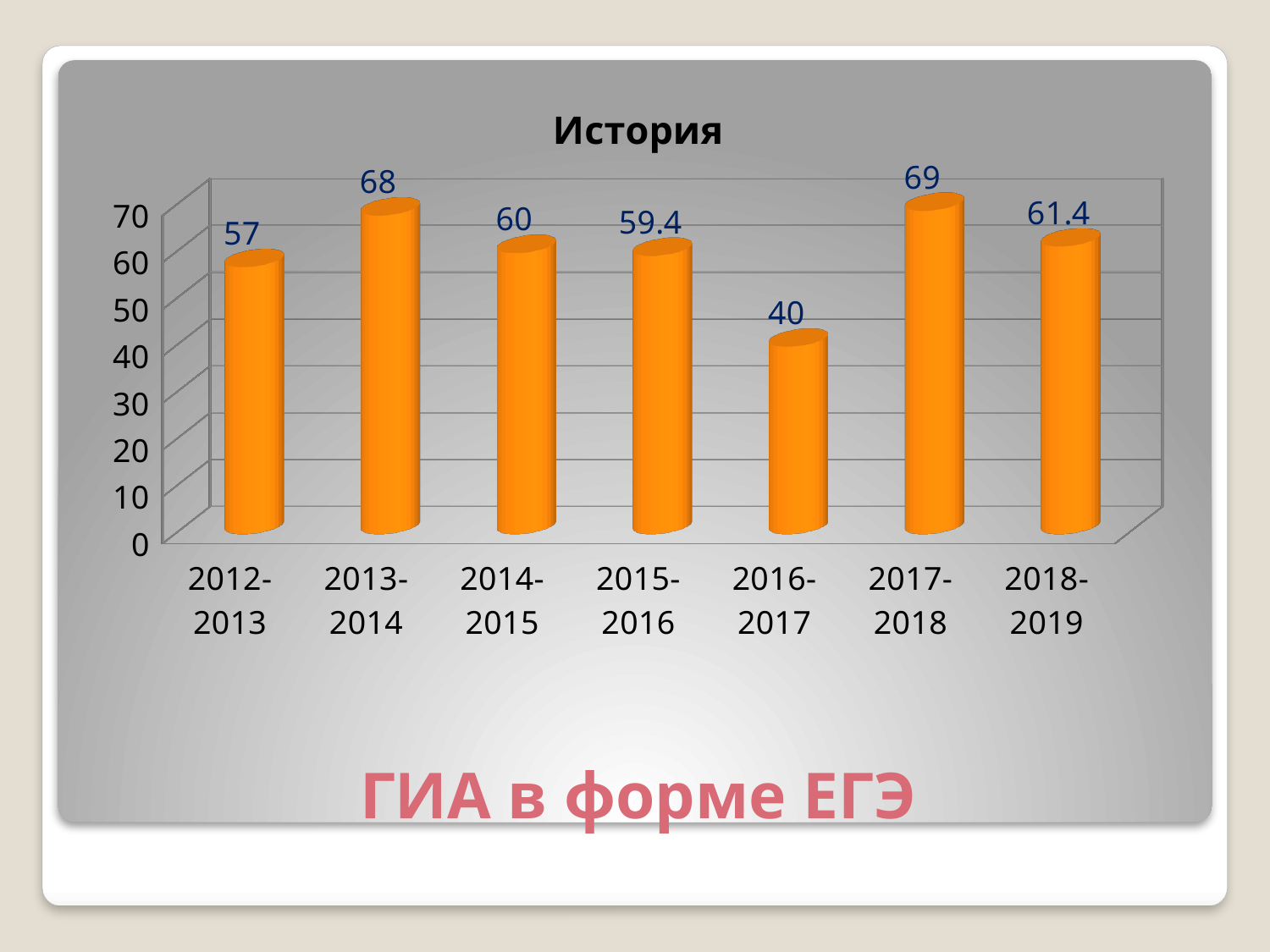
What is the difference between the values for 2013-2014 and 2016-2017? 28 What is the difference between the values for 2018-2019 and 2014-2015? 1.4 Which year has the lowest value? 2016-2017 What is the title of the chart? История What kind of chart is shown? bar chart How many years are shown on the x axis? 7 Which year has the highest value? 2017-2018 What is the value for 2012-2013? 57 Is the value for 2016-2017 greater or less than 50? less Which is larger, the value for 2013-2014 or the value for 2014-2015? 2013-2014 What is the value for 2015-2016? 59.4 What is the value for 2018-2019? 61.4